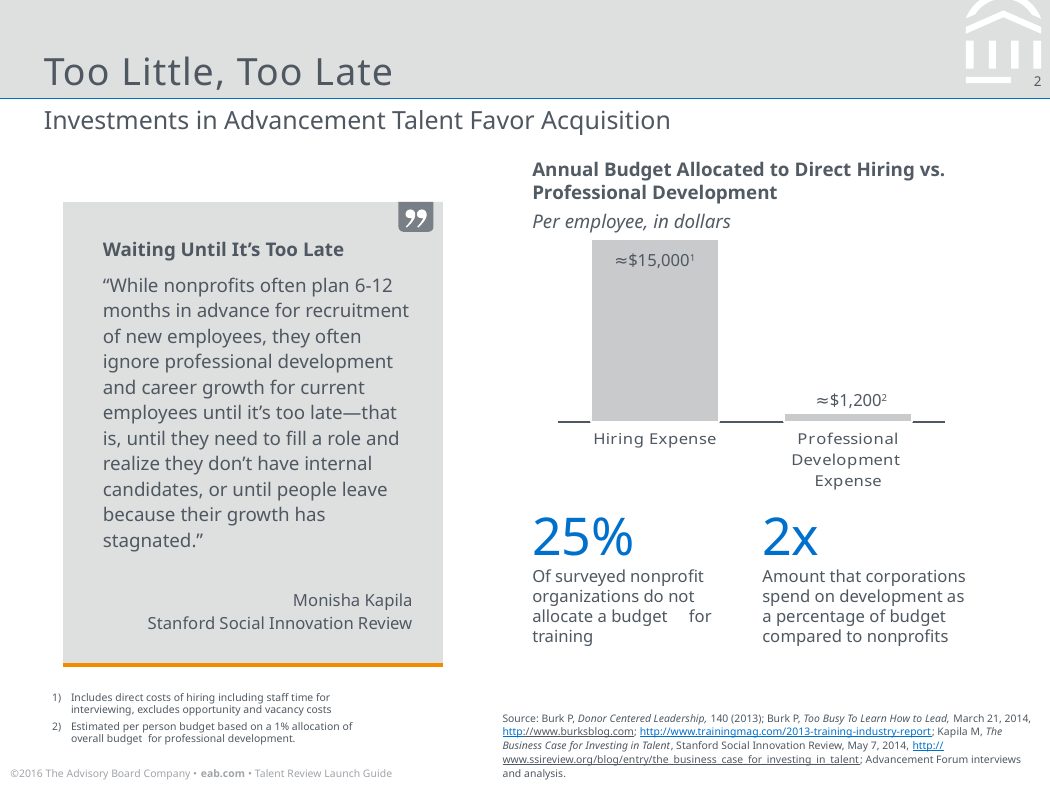
What kind of chart is shown on the slide? Bar chart Which category has the lowest value in the chart? Professional Development Expense What unit does the chart's subtitle say the values are in? Per employee, in dollars How many categories are shown in the chart? 2 Which category has the highest value in the chart? Hiring Expense Which is larger, Hiring Expense or Professional Development Expense? Hiring Expense What value is shown for Hiring Expense in the chart? ≈$15,000 What is the title of the chart? Annual Budget Allocated to Direct Hiring vs. Professional Development What value is shown for Professional Development Expense in the chart? ≈$1,200